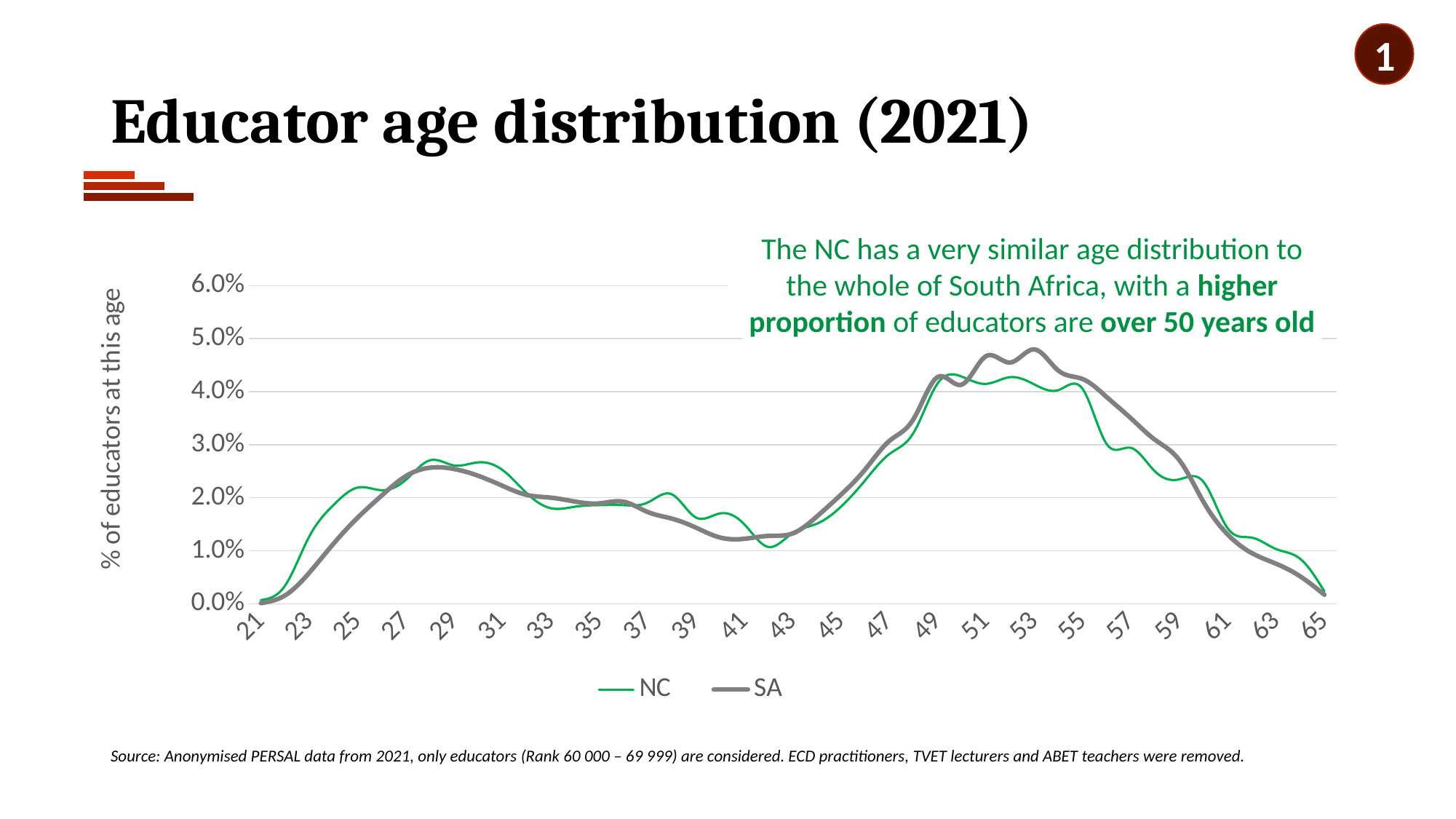
What is the label on the vertical axis? % of educators at this age How many series does the legend list? 2 At age 57, which series has the higher value, NC or SA? SA At age 25, which series has the higher value, NC or SA? NC Between ages 43 and 49, does the SA series rise or fall? rise What kind of chart is shown on the slide? line chart Is the value for NC at age 29 greater or less than 2.0%? greater What are the two series named in the legend? NC and SA Is the value for NC at age 43 greater or less than 2.0%? less Is the value for SA at age 53 greater or less than 4.0%? greater At age 53, which series has the higher value, NC or SA? SA At which age does the SA series reach its highest value? 53